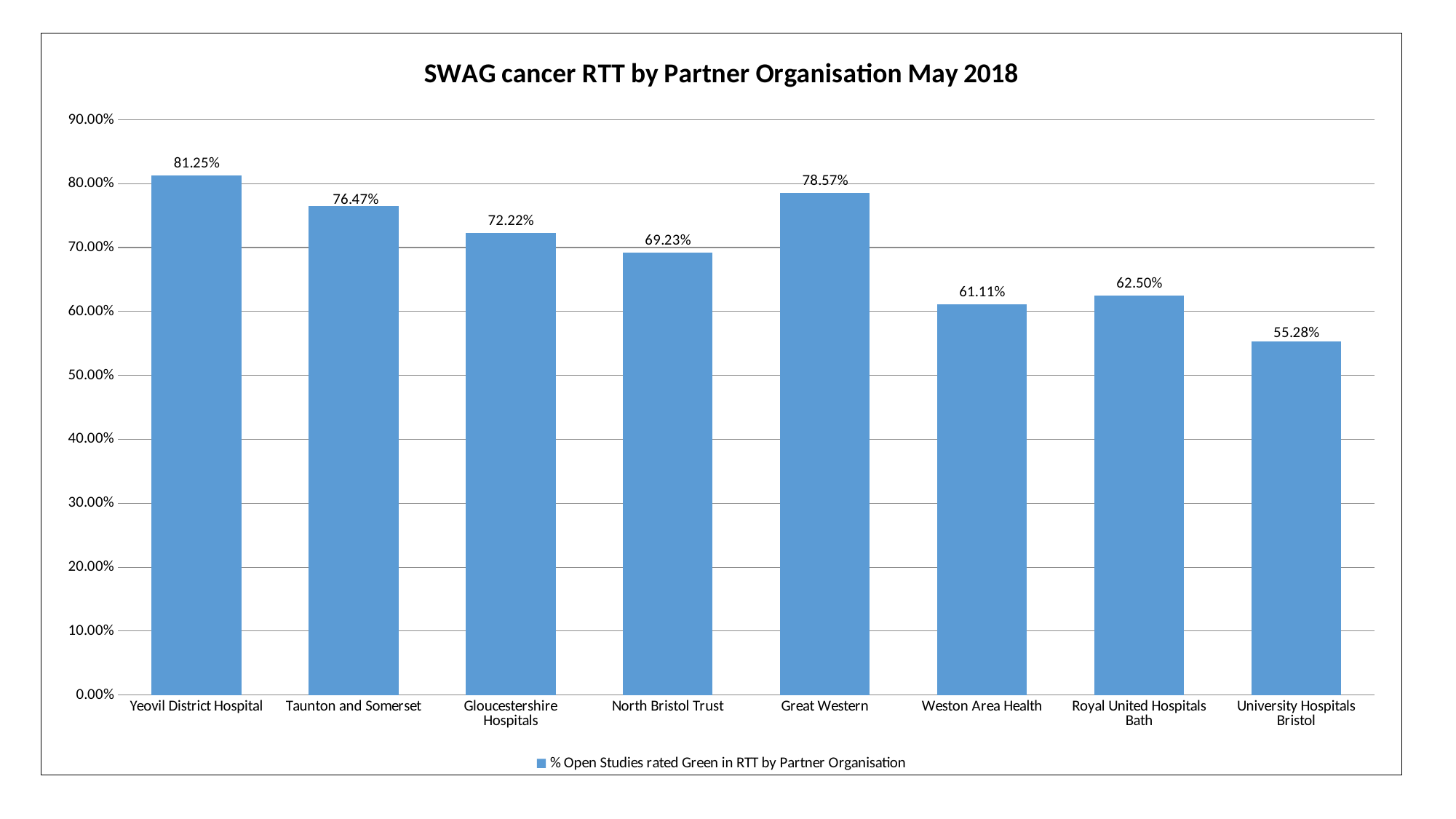
Is the value for North Bristol Trust greater or less than 70.00%? less Which is larger, the value for Taunton and Somerset or the value for Gloucestershire Hospitals? Taunton and Somerset Which partner organisation has the lowest value? University Hospitals Bristol What kind of chart is shown on the slide? bar chart What is the value for University Hospitals Bristol? 55.28% How many partner organisations are shown on the chart? 8 What is the value for Yeovil District Hospital? 81.25% How many series does the legend list? 1 What is the title of the chart? SWAG cancer RTT by Partner Organisation May 2018 What is the difference between the values for Yeovil District Hospital and University Hospitals Bristol? 25.97% What is the value for Great Western? 78.57% Which partner organisation has the highest value? Yeovil District Hospital